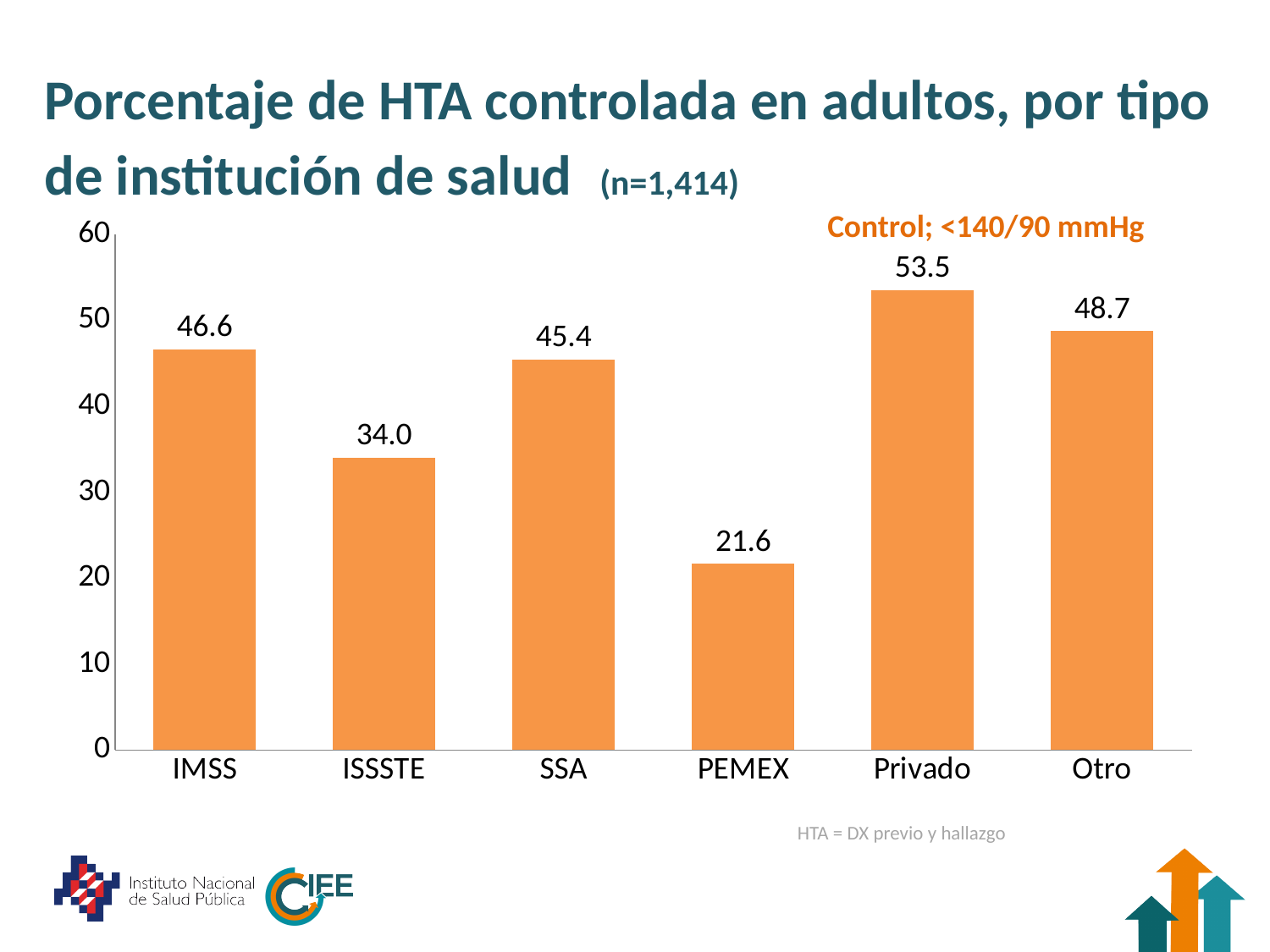
Which is larger, the value for Otro or the value for SSA? Otro How many institution types are shown on the x axis? 6 What is the difference between the values for Privado and PEMEX? 31.9 What is the value for PEMEX? 21.6 Which institution type has the highest percentage of controlled hypertension? Privado Which institution type has the lowest percentage of controlled hypertension? PEMEX What is the sample size (n) stated in the chart title? 1,414 Is the value for ISSSTE greater or less than 40? less What is the value for Privado? 53.5 What is the value for IMSS? 46.6 What kind of chart is shown on the slide? bar chart What is the difference between the values for IMSS and ISSSTE? 12.6